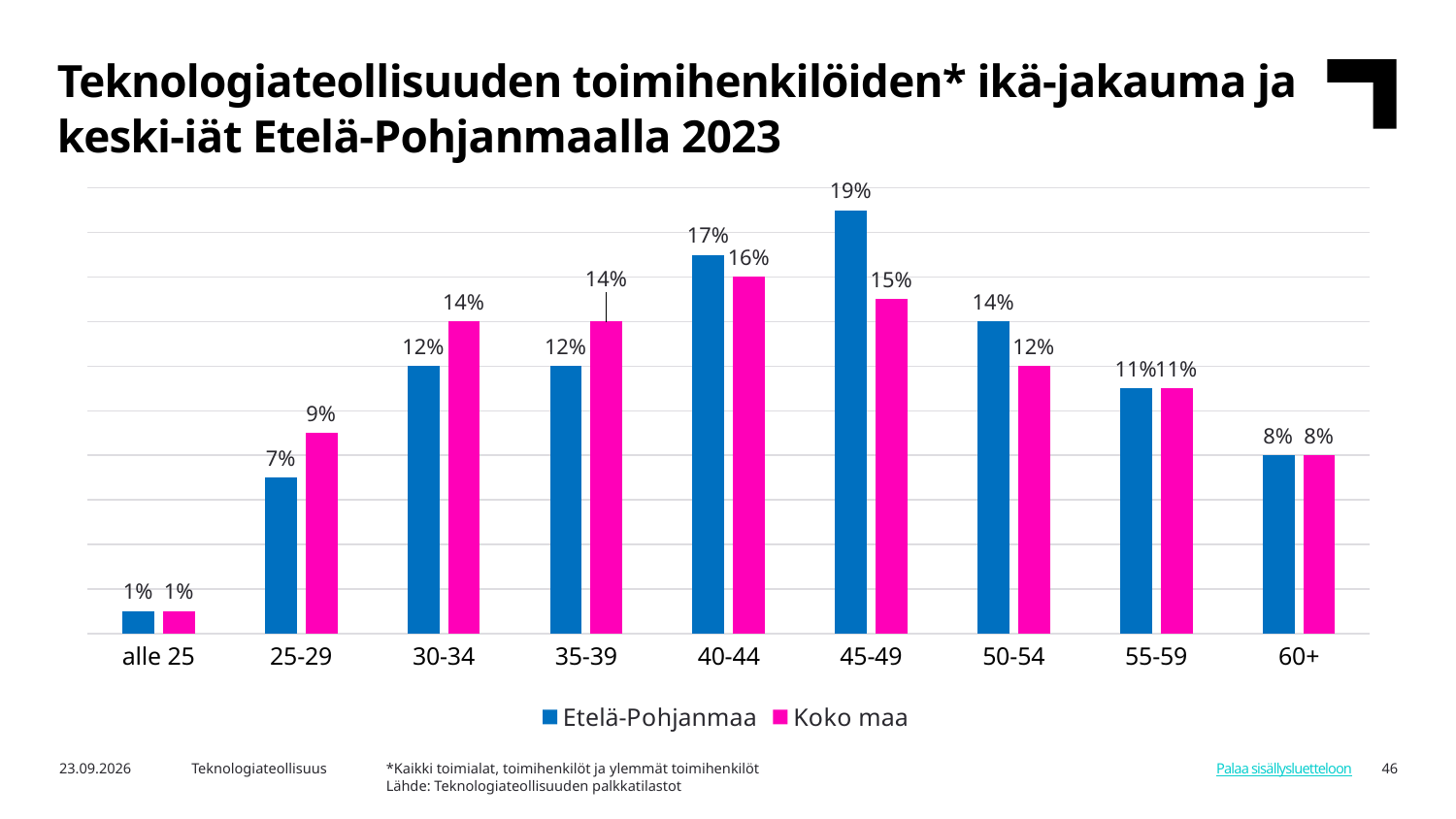
What is the difference between Etelä-Pohjanmaa and Koko maa in the 45-49 age group? 4 percentage points What kind of chart is shown on the slide? Bar chart How many series does the legend list? 2 What is the value for Etelä-Pohjanmaa in the 40-44 age group? 17% Which age group has the highest value for Koko maa? 40-44 Which age group has the highest value for Etelä-Pohjanmaa? 45-49 In the 30-34 age group, which series has the larger value, Etelä-Pohjanmaa or Koko maa? Koko maa In the 50-54 age group, which series has the larger value, Etelä-Pohjanmaa or Koko maa? Etelä-Pohjanmaa How many age groups are shown on the x axis? 9 Which age group has the lowest value for Koko maa? alle 25 What is the value for Etelä-Pohjanmaa in the 45-49 age group? 19% What is the value for Koko maa in the 25-29 age group? 9%